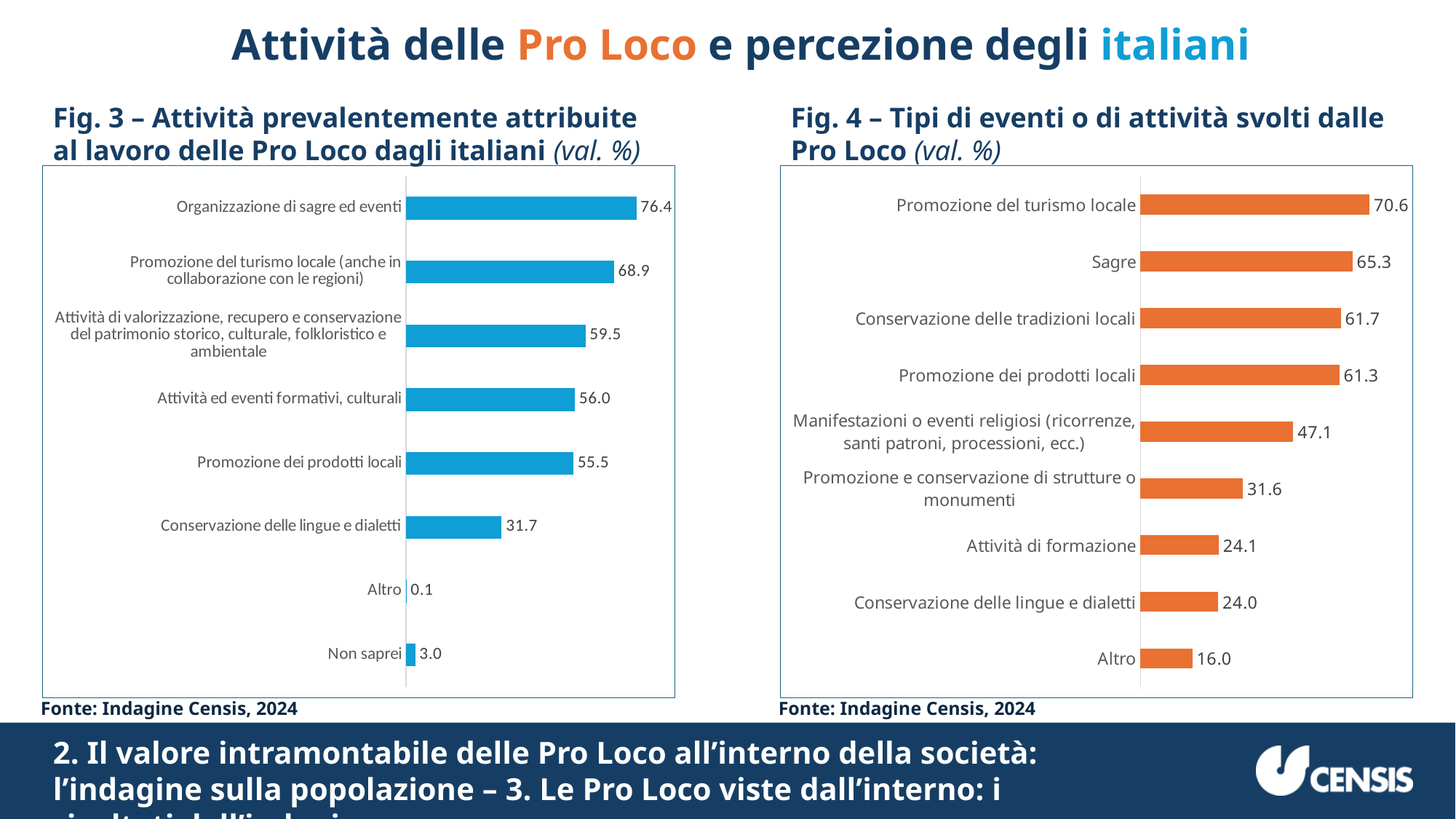
In Fig. 4, which category has the highest value? Promozione del turismo locale In Fig. 4, what is the difference between "Promozione del turismo locale" and "Attività di formazione"? 46.5 In Fig. 4, what is the value for "Altro"? 16.0 In Fig. 3, how many categories are shown? 8 What type of chart is Fig. 4? Bar chart In Fig. 3, what is the value for "Organizzazione di sagre ed eventi"? 76.4 What colour are the bars in Fig. 3? Blue In Fig. 3, which is larger: "Attività ed eventi formativi, culturali" or "Promozione dei prodotti locali"? Attività ed eventi formativi, culturali In Fig. 3, what is the difference between "Promozione del turismo locale (anche in collaborazione con le regioni)" and "Conservazione delle lingue e dialetti"? 37.2 In Fig. 4, how many categories are shown? 9 In Fig. 3, which category has the lowest value? Altro In Fig. 4, what is the value for "Sagre"? 65.3